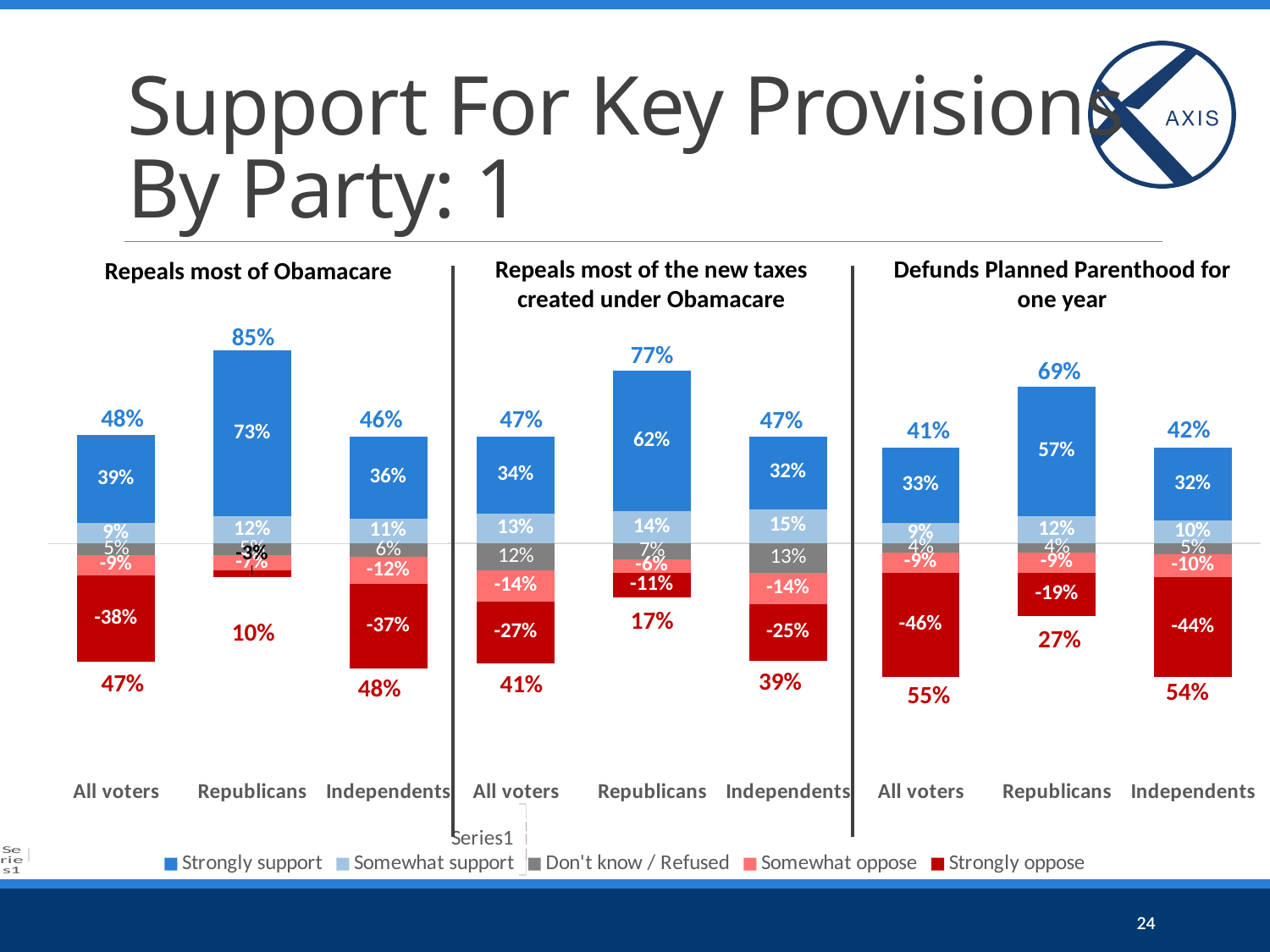
How many categories are shown on the x axis of the 'Repeals most of the new taxes created under Obamacare' chart? 3 In the 'Defunds Planned Parenthood for one year' chart, is the Strongly support value larger for All voters or for Independents? All voters What kind of chart is the 'Repeals most of Obamacare' chart? Stacked bar chart In the 'Repeals most of Obamacare' chart, what is the Strongly oppose value for All voters? -38% In the 'Repeals most of the new taxes created under Obamacare' chart, which category has the lowest Somewhat support value? All voters In the 'Repeals most of Obamacare' chart, what is the difference between the Strongly support values for Republicans and Independents? 37% In the 'Repeals most of the new taxes created under Obamacare' chart, what is the Strongly support value for Republicans? 62% In the 'Repeals most of Obamacare' chart, what is the Strongly support value for Republicans? 73% How many series does the legend list? 5 In the 'Defunds Planned Parenthood for one year' chart, which category has the highest Strongly support value? Republicans In the 'Repeals most of the new taxes created under Obamacare' chart, what is the Don't know / Refused value for Independents? 13% In the 'Defunds Planned Parenthood for one year' chart, what is the Strongly oppose value for Independents? -44%